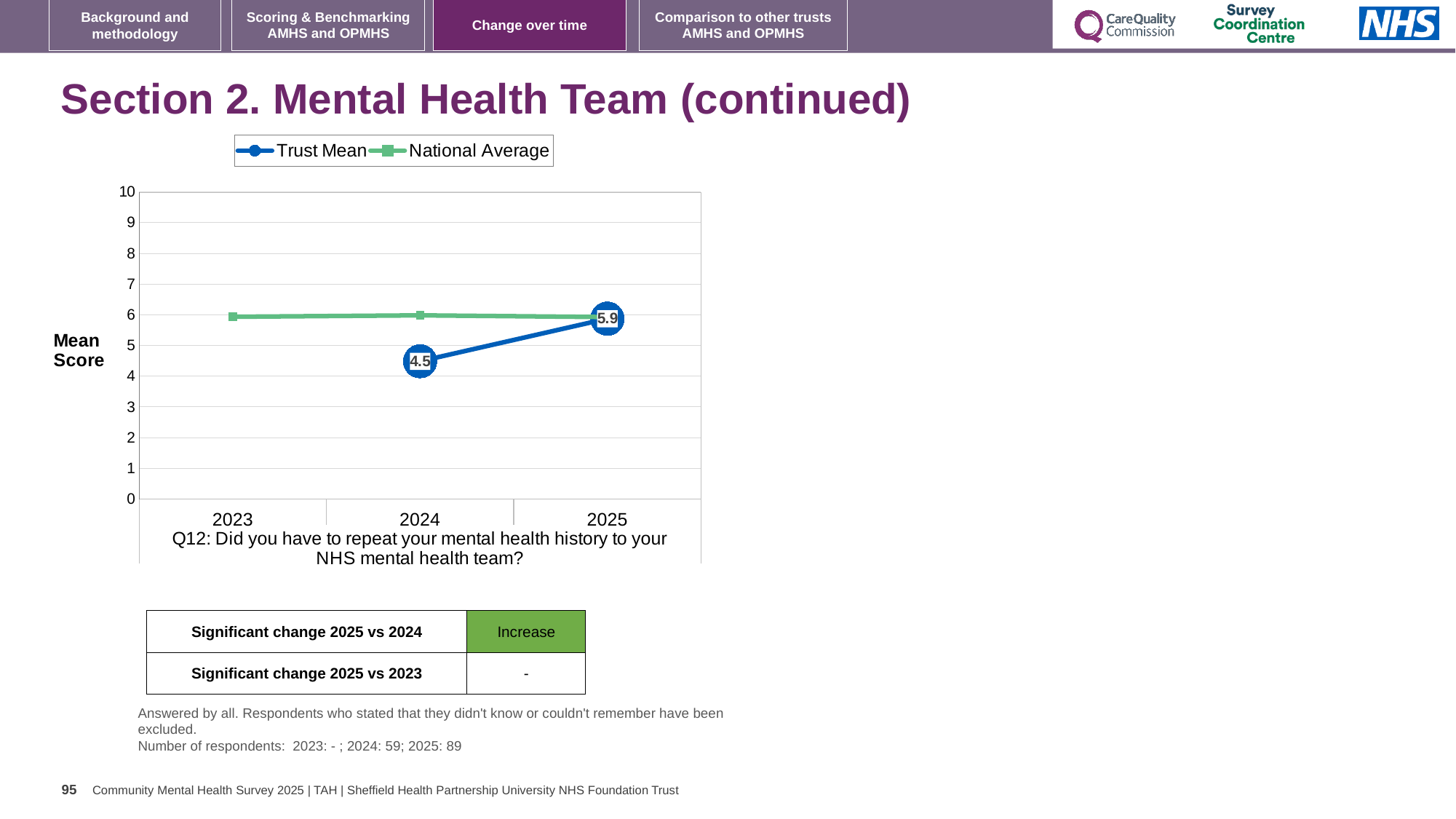
What kind of chart is shown on the slide? line chart By how much did the Trust Mean score change from 2024 to 2025? 1.4 What is the label of the y axis? Mean Score How many years are shown on the x axis? 3 In 2024, which is larger, the Trust Mean or the National Average? National Average Is the National Average value for 2023 greater or less than 5? greater Did the Trust Mean rise or fall from 2024 to 2025? rise What is the Trust Mean score for 2025? 5.9 How many series does the legend list? 2 What is the Trust Mean score for 2024? 4.5 Is the National Average value for 2024 greater or less than 7? less Which year has the higher Trust Mean score, 2024 or 2025? 2025